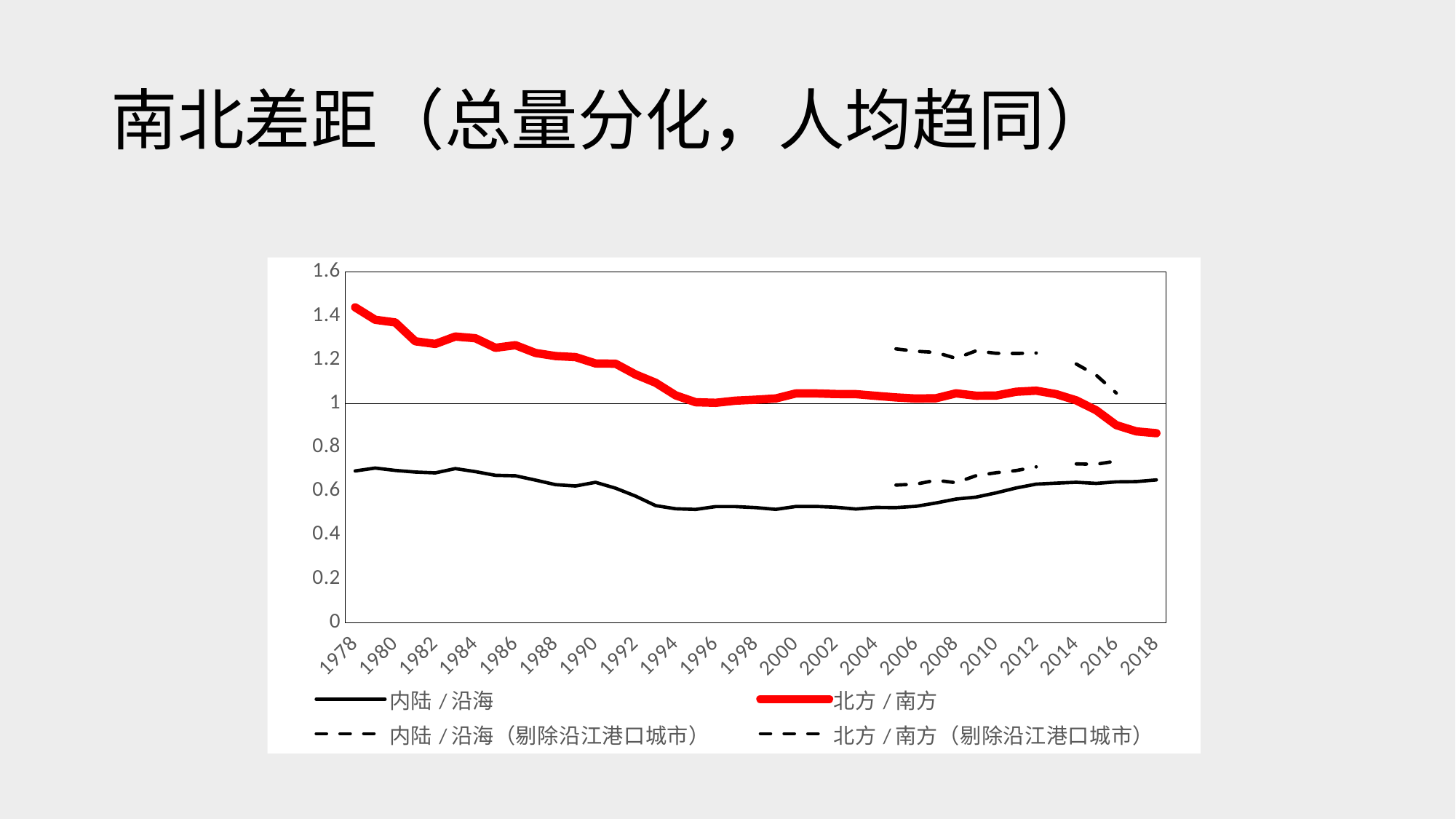
Is the value for 北方 / 南方（剔除沿江港口城市） in 2006 greater or less than 1.2? greater Which series is drawn in red? 北方 / 南方 In 2010, which is higher, 内陆 / 沿海（剔除沿江港口城市） or 内陆 / 沿海? 内陆 / 沿海（剔除沿江港口城市） What kind of chart is shown on the slide? line chart Is the value for 北方 / 南方 in 2018 greater or less than 1? less Is the value for 内陆 / 沿海 in 1996 greater or less than 0.6? less How many series does the legend list? 4 In 1978, which series has the higher value, 北方 / 南方 or 内陆 / 沿海? 北方 / 南方 Does the 北方 / 南方 series rise or fall from 1978 to 2018? fall Does the 内陆 / 沿海 series rise or fall from 2004 to 2018? rise